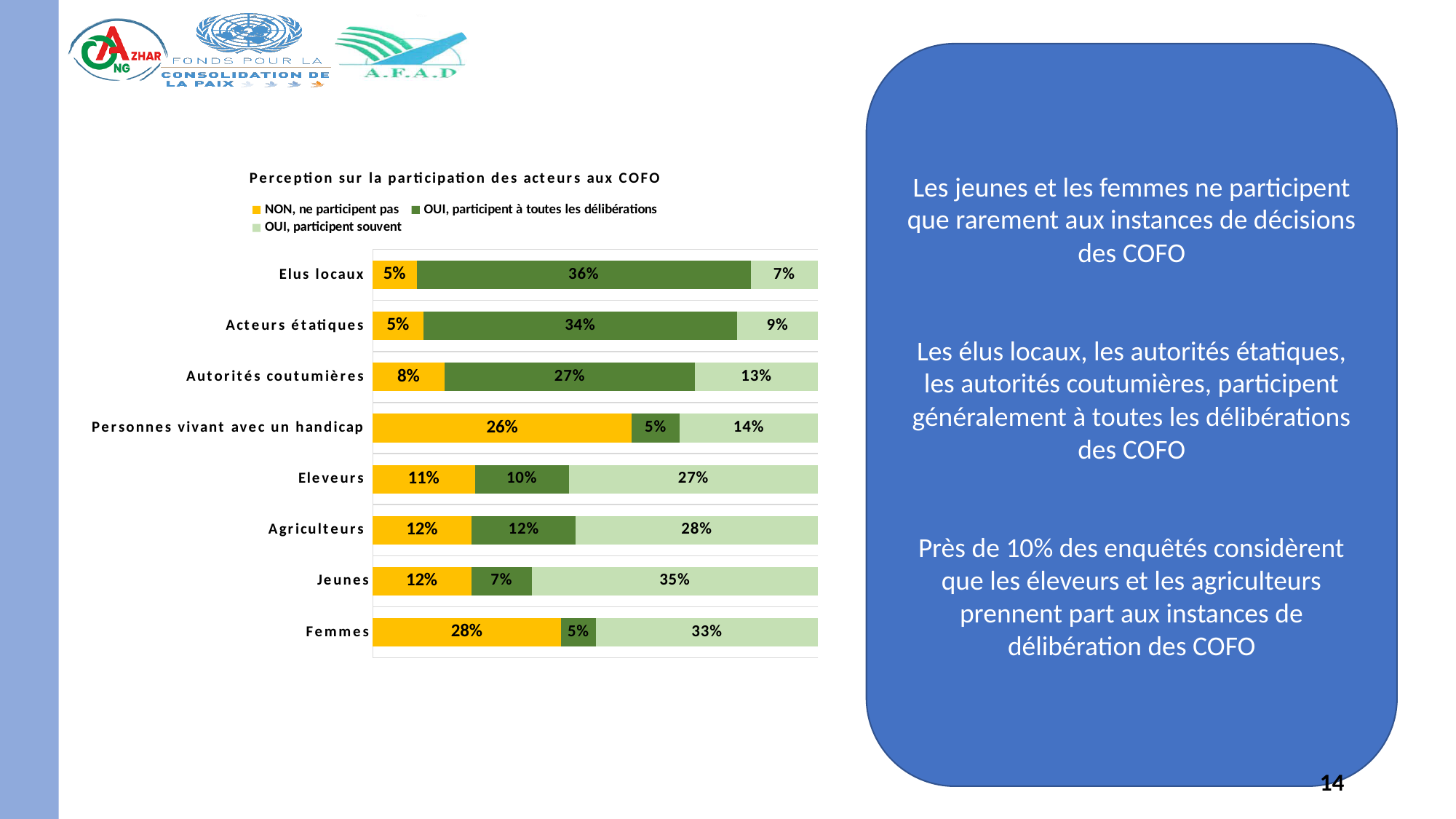
What is the value of 'OUI, participent à toutes les délibérations' for Elus locaux? 36% What is the value of 'OUI, participent souvent' for Jeunes? 35% Which is larger: the 'OUI, participent souvent' value for Agriculteurs or for Eleveurs? Agriculteurs How many series does the chart legend list? 3 What is the value of 'NON, ne participent pas' for Femmes? 28% Which category has the highest value for 'NON, ne participent pas'? Femmes Which category has the lowest value for 'OUI, participent souvent'? Elus locaux What kind of chart is shown on the slide? Stacked bar chart What is the total of the three segments for the Femmes bar? 66% How many categories (actor groups) are shown in the chart? 8 What is the title of the chart? Perception sur la participation des acteurs aux COFO What is the difference between the 'OUI, participent à toutes les délibérations' values for Elus locaux and Autorités coutumières? 9%